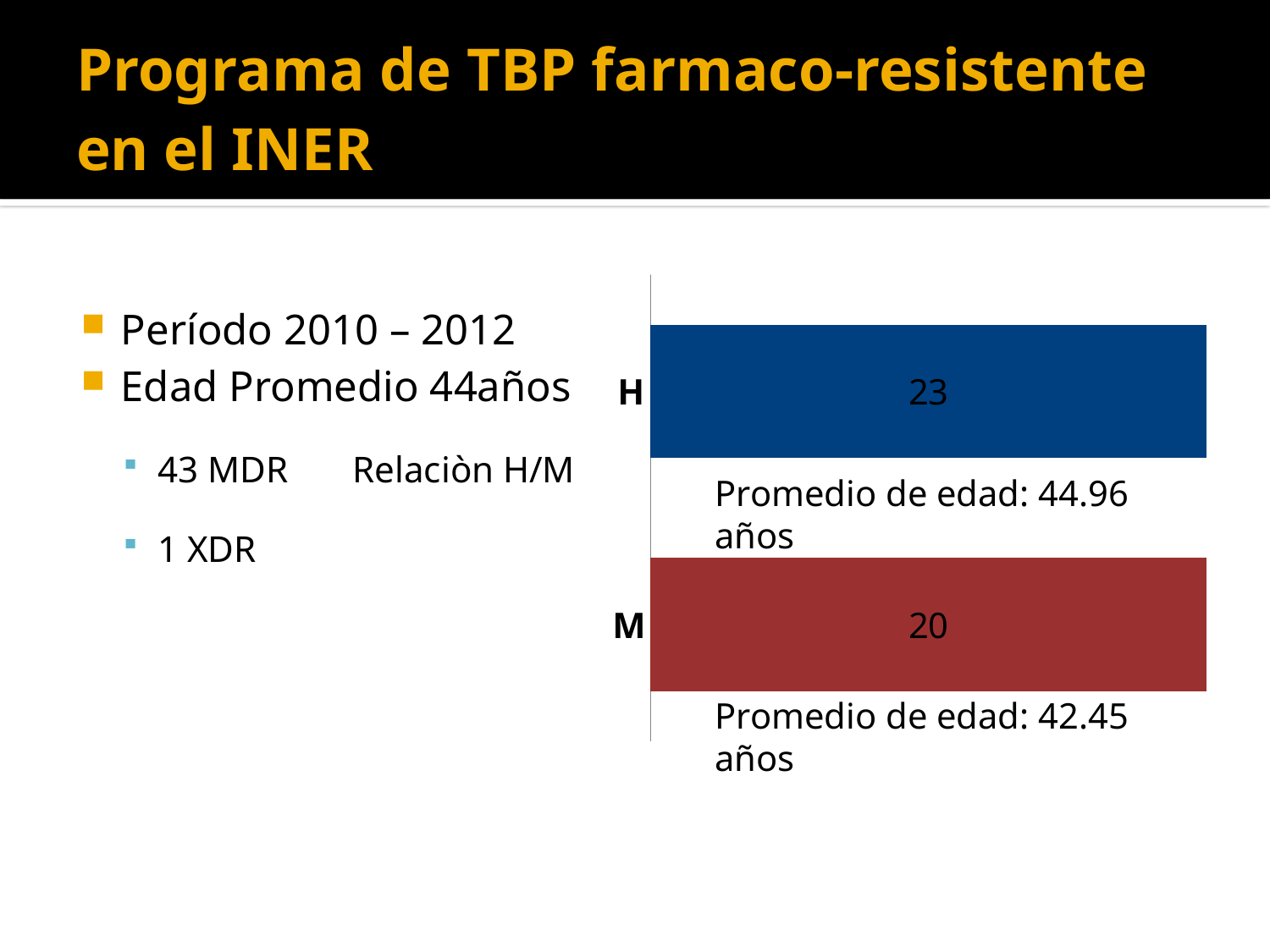
What is the total of the values for H and M in the bar chart? 43 What average age (Promedio de edad) is noted for category H on the chart? 44.96 años How many categories are shown in the bar chart? 2 What average age (Promedio de edad) is noted for category M on the chart? 42.45 años Which category has the lowest value in the bar chart? M What type of chart is shown on the slide? bar chart What is the difference between the values for H and M in the bar chart? 3 Which category has the higher value in the bar chart, H or M? H What is the value shown for category H in the bar chart? 23 What is the value shown for category M in the bar chart? 20 Which category has the highest value in the bar chart? H